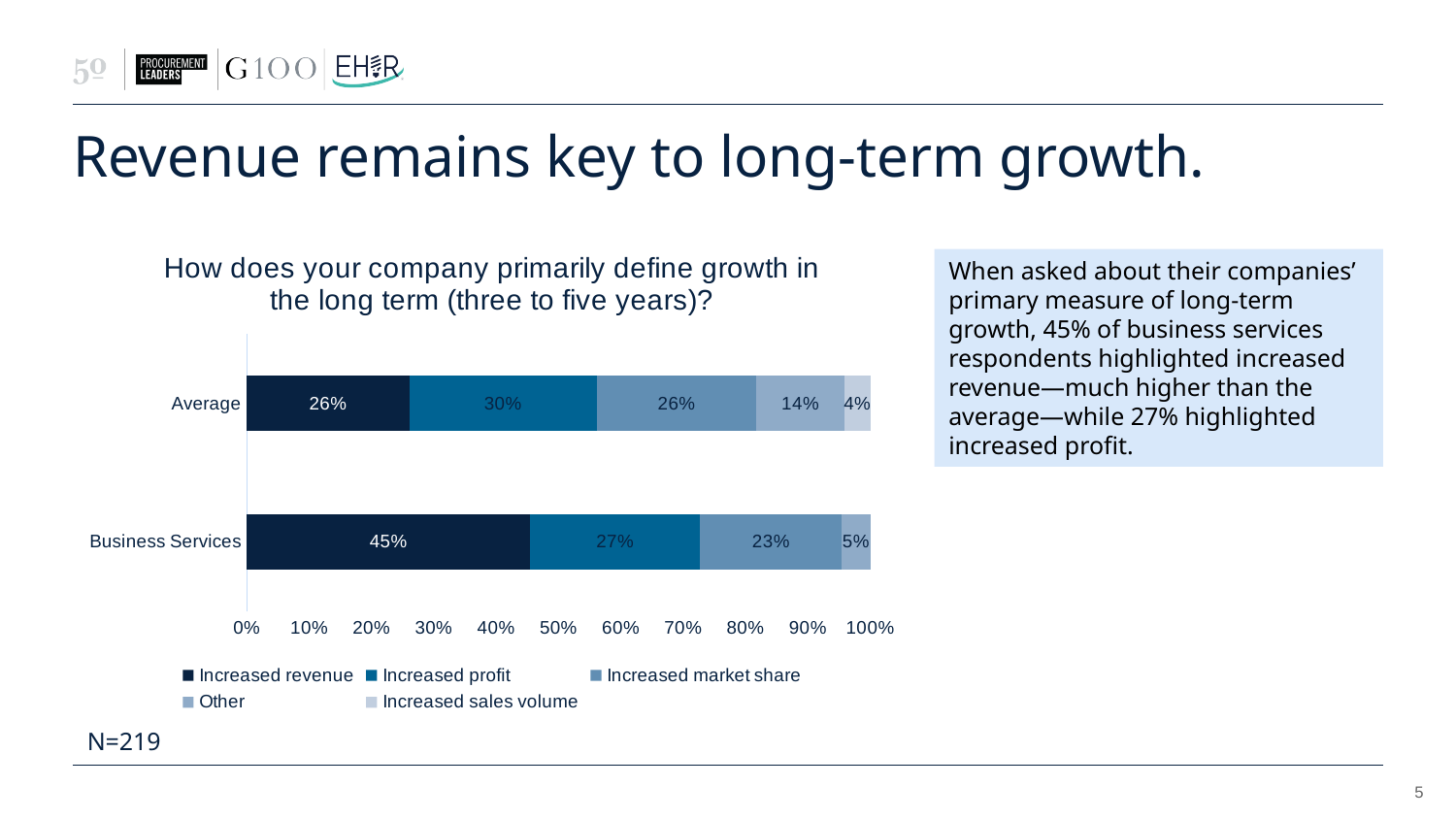
What is the Increased sales volume value for Average? 4% What is the difference between the Increased revenue values for Business Services and Average? 19 percentage points What is the Increased market share value for Business Services? 23% What is the Increased revenue value for Business Services? 45% What kind of chart is shown on the slide? Stacked bar chart Which category has the higher Increased revenue value, Average or Business Services? Business Services What is the title of the chart? How does your company primarily define growth in the long term (three to five years)? What is the Increased profit value for Average? 30% How many categories are shown on the y axis? 2 Which segment is the largest in the Average bar? Increased profit How many series does the legend list? 5 What is the Other value for Average? 14%